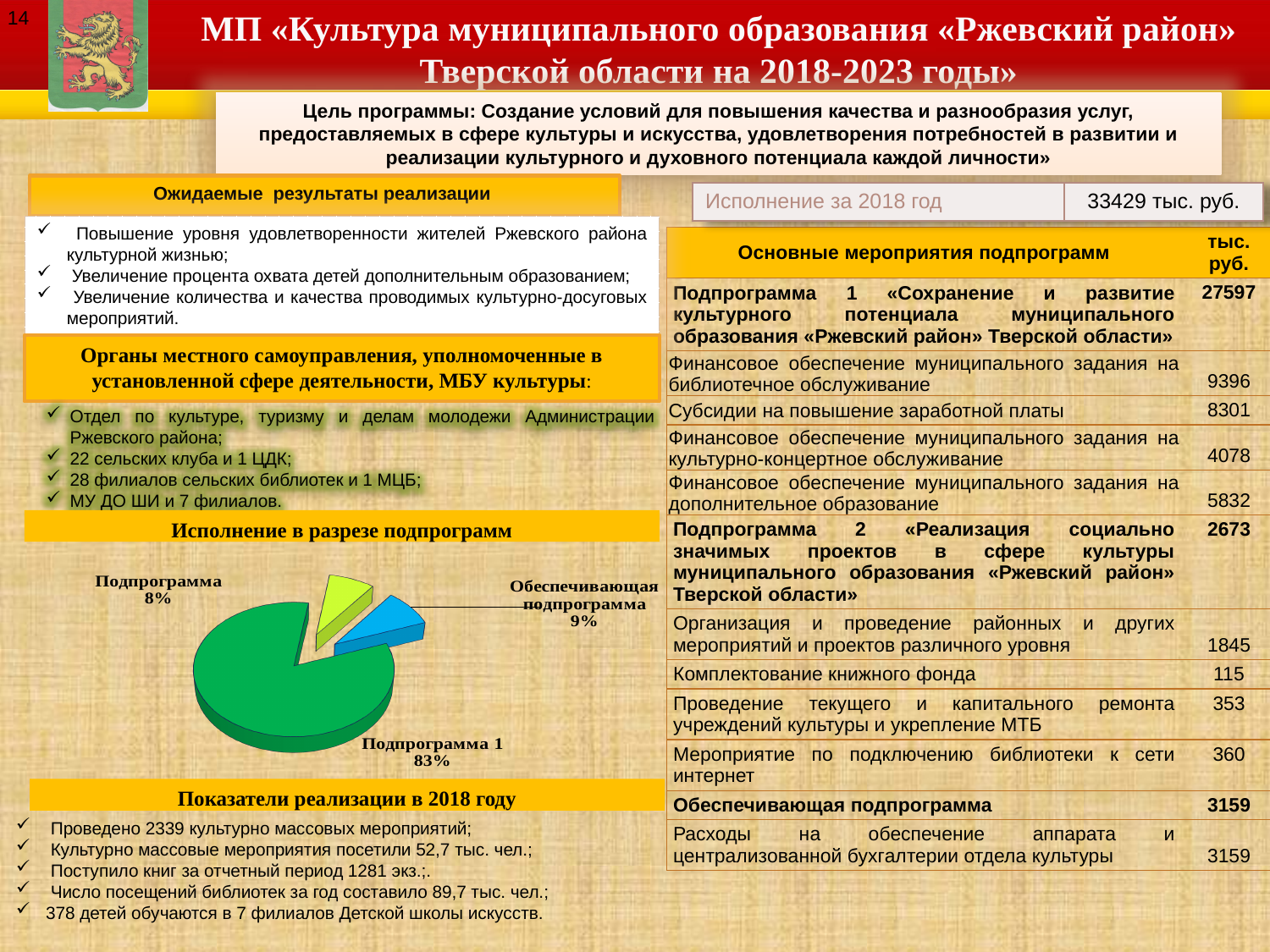
In the pie chart «Исполнение в разрезе подпрограмм», what share does «Обеспечивающая подпрограмма» have? 9% In the pie chart «Исполнение в разрезе подпрограмм», what is the difference in percentage points between «Обеспечивающая подпрограмма» and the slice labelled «Подпрограмма»? 1 percentage point In the pie chart «Исполнение в разрезе подпрограмм», which slice is the smallest? Подпрограмма (8%) What kind of chart is shown under the heading «Исполнение в разрезе подпрограмм»? Pie chart In the pie chart «Исполнение в разрезе подпрограмм», how many slices are there? 3 In the pie chart «Исполнение в разрезе подпрограмм», what is the difference in percentage points between «Подпрограмма 1» and «Обеспечивающая подпрограмма»? 74 percentage points In the pie chart «Исполнение в разрезе подпрограмм», which is larger: «Обеспечивающая подпрограмма» or the slice labelled «Подпрограмма»? Обеспечивающая подпрограмма What is the title shown above the pie chart on the slide? Исполнение в разрезе подпрограмм In the pie chart «Исполнение в разрезе подпрограмм», which slice is the largest? Подпрограмма 1 In the pie chart «Исполнение в разрезе подпрограмм», what share does «Подпрограмма 1» have? 83% In the pie chart «Исполнение в разрезе подпрограмм», what colour is the «Подпрограмма 1» slice? Green In the pie chart «Исполнение в разрезе подпрограмм», what share does the slice labelled «Подпрограмма» have? 8%